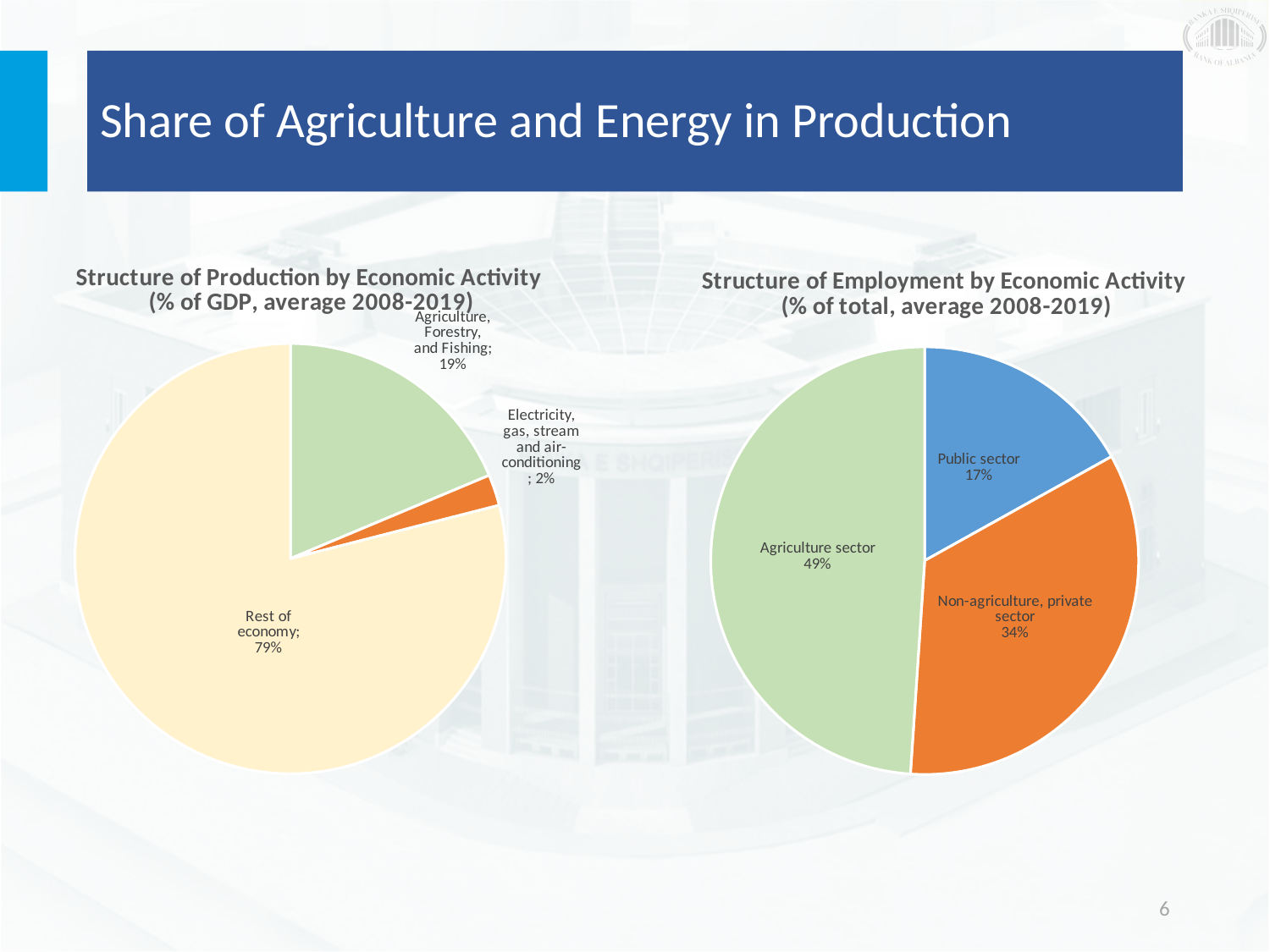
In the 'Structure of Employment by Economic Activity' chart, which category has the largest share? Agriculture sector In the 'Structure of Production by Economic Activity' chart, which is larger: 'Agriculture, Forestry, and Fishing' or 'Electricity, gas, stream and air-conditioning'? Agriculture, Forestry, and Fishing In the 'Structure of Employment by Economic Activity' chart, what is the difference between the 'Agriculture sector' and the 'Non-agriculture, private sector' shares? 15% In the 'Structure of Production by Economic Activity' chart, what share does 'Rest of economy' have? 79% What colour is the 'Public sector' slice in the 'Structure of Employment by Economic Activity' chart? Blue What type of chart is the 'Structure of Production by Economic Activity' chart? Pie chart How many slices does the 'Structure of Employment by Economic Activity' chart have? 3 In the 'Structure of Production by Economic Activity' chart, what share does 'Electricity, gas, stream and air-conditioning' have? 2% In the 'Structure of Production by Economic Activity' chart, which category has the smallest share? Electricity, gas, stream and air-conditioning In the 'Structure of Employment by Economic Activity' chart, what share does the 'Public sector' have? 17% In the 'Structure of Employment by Economic Activity' chart, what share does the 'Agriculture sector' have? 49% In the 'Structure of Production by Economic Activity' chart, what share does 'Agriculture, Forestry, and Fishing' have? 19%